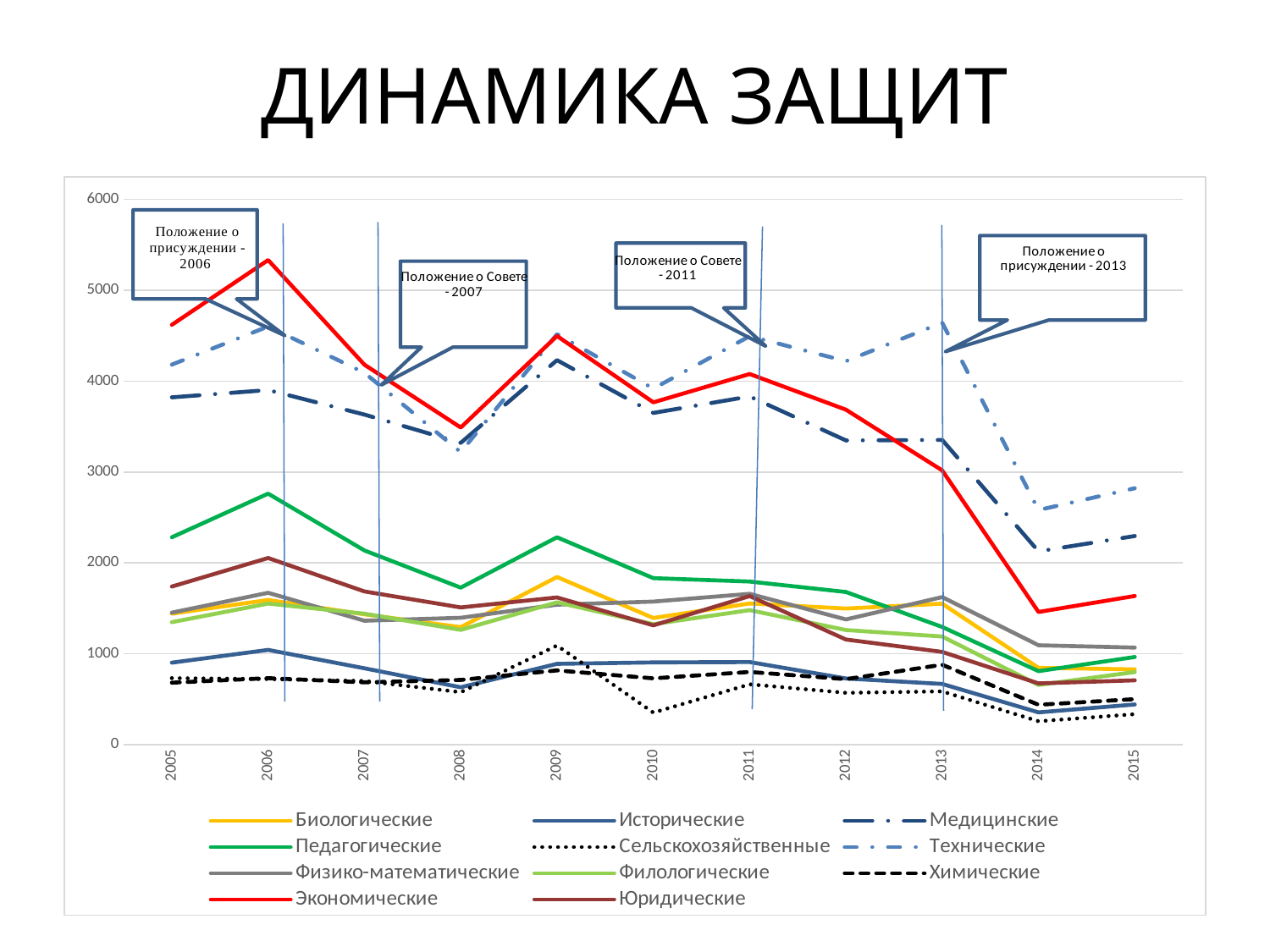
What is the title of the slide? ДИНАМИКА ЗАЩИТ Which series has the highest value in 2006? Экономические What kind of chart is shown on the slide? line chart Is the value for Экономические in 2014 greater or less than 2000? less Is the value for Экономические in 2006 greater or less than 5000? greater How many years are plotted along the x axis? 11 How many series does the legend list? 11 Is the value for Технические in 2013 greater or less than 4000? greater Which is larger in 2006, Педагогические or Юридические? Педагогические Which series has the highest value in 2015? Технические Does the Экономические series rise or fall from 2013 to 2014? fall